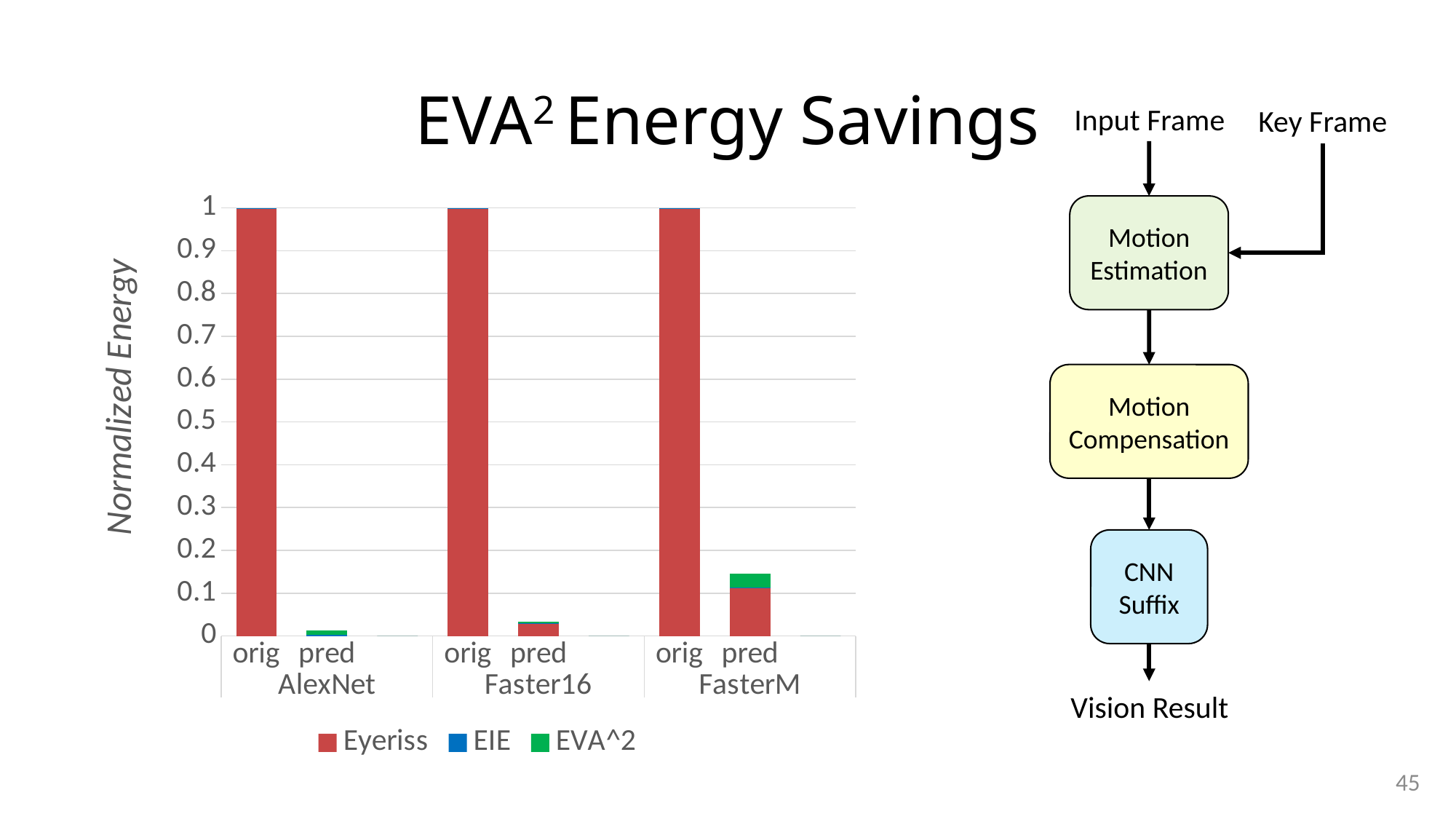
Which network has the tallest pred bar? FasterM What are the three series named in the chart legend? Eyeriss, EIE, EVA^2 For AlexNet, which bar is taller, orig or pred? orig Which network has the shortest pred bar? AlexNet How many bars are plotted in the chart? 6 Is the total value of the pred bar for FasterM greater or less than 0.1? greater What is the label of the vertical axis of the chart? Normalized Energy What kind of chart is shown on the slide? bar chart Is the total value of the pred bar for Faster16 greater or less than 0.1? less Is the total value of the pred bar for FasterM greater or less than 0.2? less What is the total height of the orig bar for AlexNet? 1 How many series does the chart legend list? 3